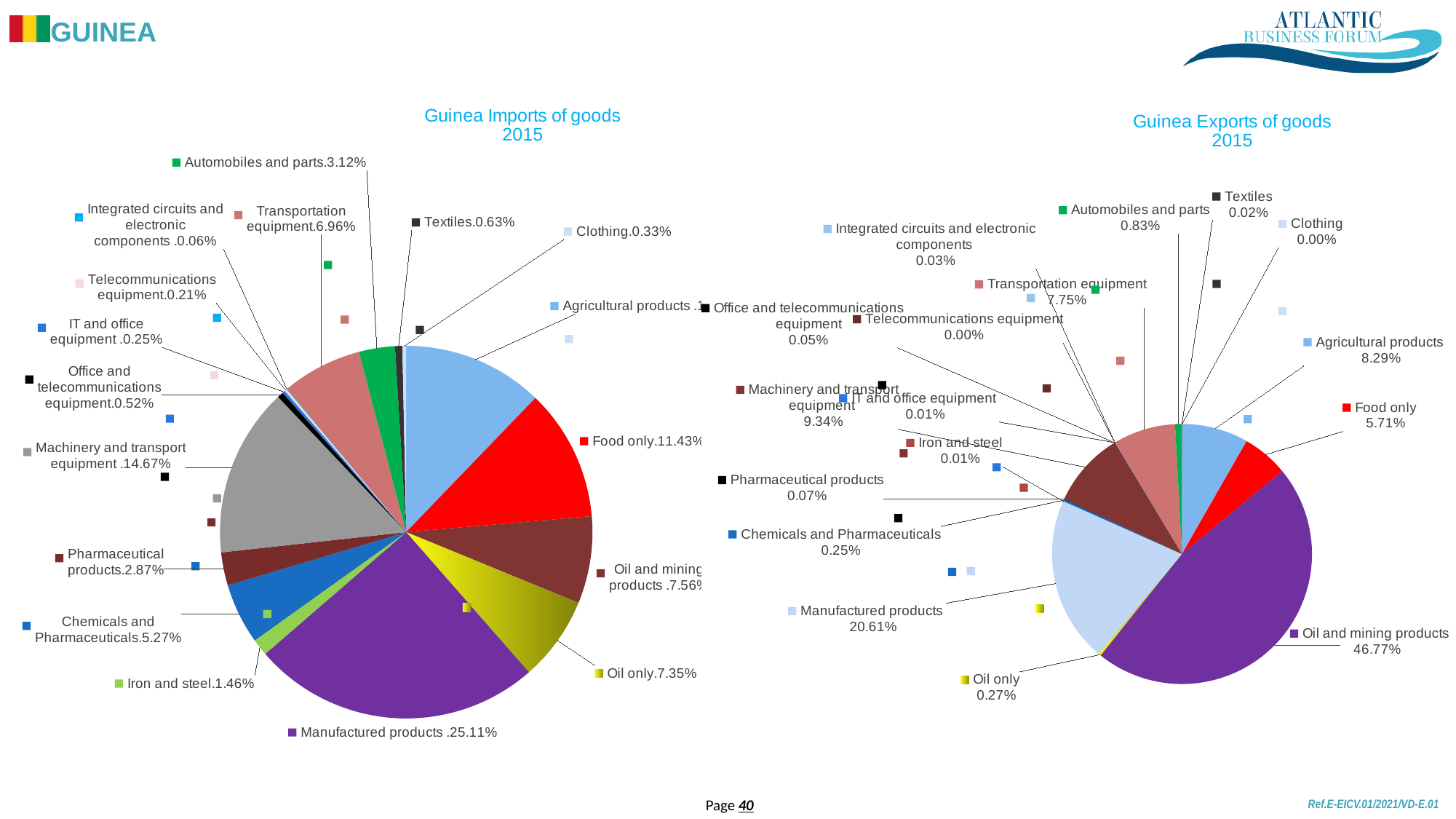
What type of chart is used for Guinea Exports of goods 2015? Pie chart In the Guinea Imports of goods 2015 chart, which category has the smallest share? Integrated circuits and electronic components In the Guinea Exports of goods 2015 chart, which category has the largest share? Oil and mining products In the Guinea Imports of goods 2015 chart, what share do Manufactured products have? 25.11% In the Guinea Exports of goods 2015 chart, what share do Manufactured products have? 20.61% In the Guinea Exports of goods 2015 chart, what is the difference between the shares of Machinery and transport equipment and Food only? 3.63% In the Guinea Imports of goods 2015 chart, what is the difference between the shares of Food only and Oil only? 4.08% In the Guinea Imports of goods 2015 chart, which is larger: Transportation equipment or Chemicals and Pharmaceuticals? Transportation equipment In the Guinea Exports of goods 2015 chart, which is larger: Agricultural products or Transportation equipment? Agricultural products In the Guinea Imports of goods 2015 chart, which category has the largest share? Manufactured products In the Guinea Imports of goods 2015 chart, what share does Machinery and transport equipment have? 14.67% In the Guinea Exports of goods 2015 chart, what share do Oil and mining products have? 46.77%